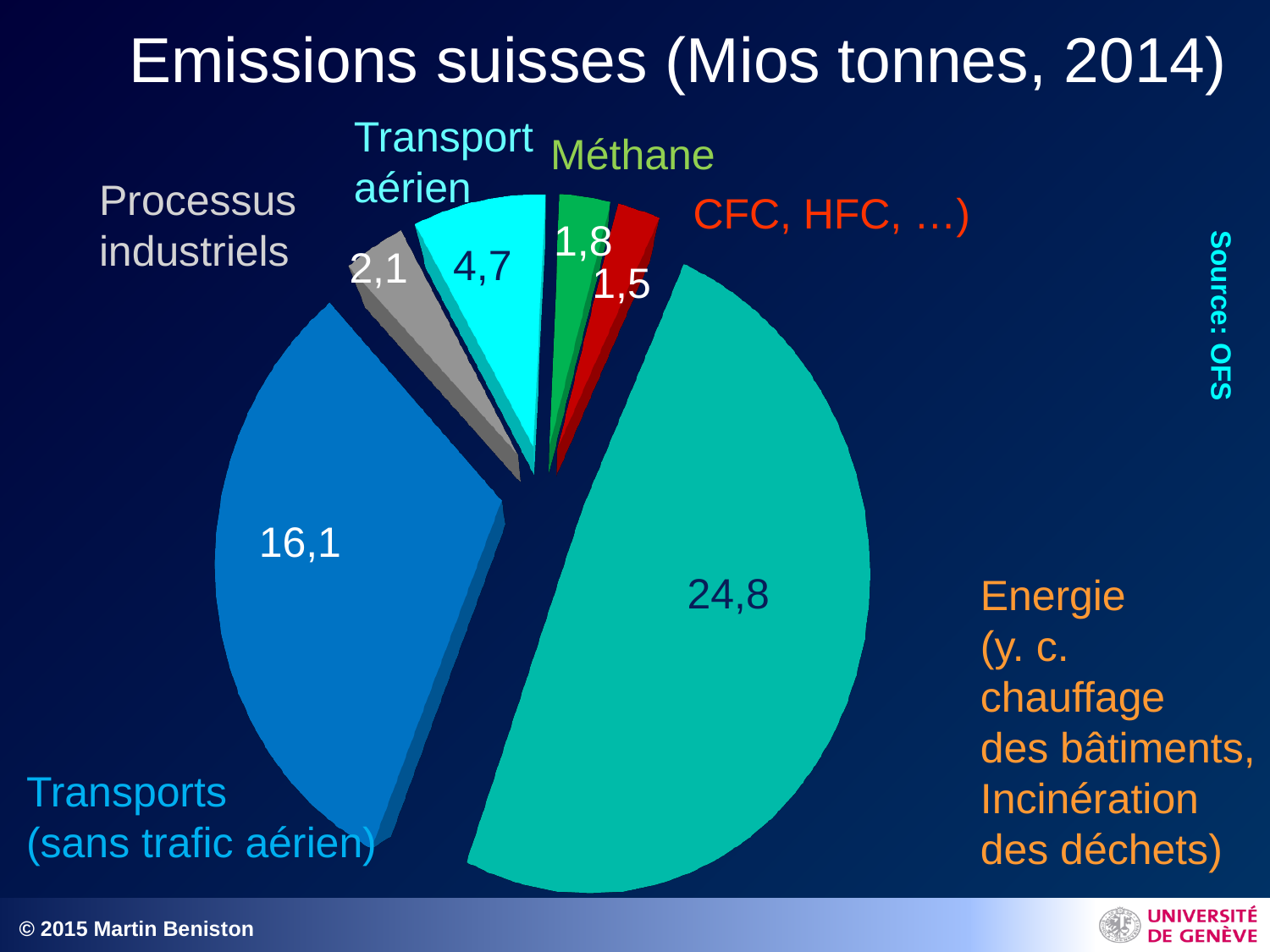
Which category has the largest slice of the pie? Energie What is the value for Energie (y. c. chauffage des bâtiments, Incinération des déchets)? 24,8 What is the value for Transport aérien? 4,7 What is the title of the chart? Emissions suisses (Mios tonnes, 2014) How many categories are shown in the pie chart? 6 Which is larger, the value for Processus industriels or the value for Méthane? Processus industriels What is the value for Transports (sans trafic aérien)? 16,1 What type of chart is shown on the slide? Pie chart Which category has the smallest slice of the pie? CFC, HFC, … What is the value for Méthane? 1,8 What is the difference between the Transport aérien value and the Processus industriels value? 2,6 What is the difference between the Energie value and the Transports (sans trafic aérien) value? 8,7